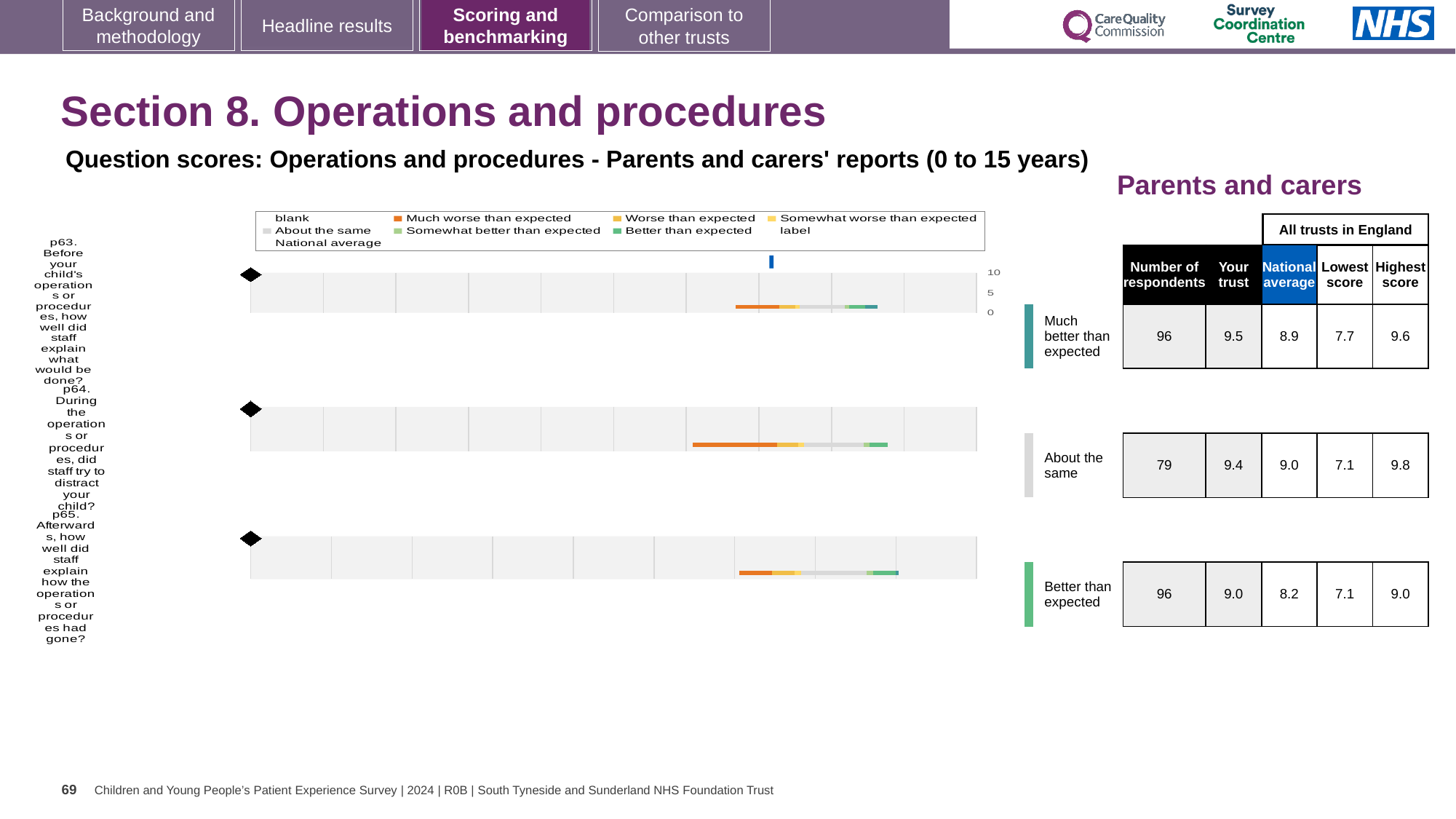
Which question has the highest 'Your trust' score? p63 What is the 'Your trust' score for p63 (how well staff explained what would be done before the operation)? 9.5 What is the lowest score among all trusts in England for p63? 7.7 What is the difference between the 'Your trust' score and the national average for p65? 0.8 Which benchmark category is shown for p63? Much better than expected Which question has the lowest 'Your trust' score? p65 For p64, which is larger: the 'Your trust' score or the national average? Your trust How many questions (p63, p64, p65) are plotted on the slide? 3 What is the national average score for p64 (did staff try to distract your child during the operation)? 9.0 What kind of chart is used to show the question scores for p63, p64 and p65? bar chart How many respondents answered p65 (how well staff explained how the operation had gone)? 96 What is the highest score among all trusts in England for p64? 9.8